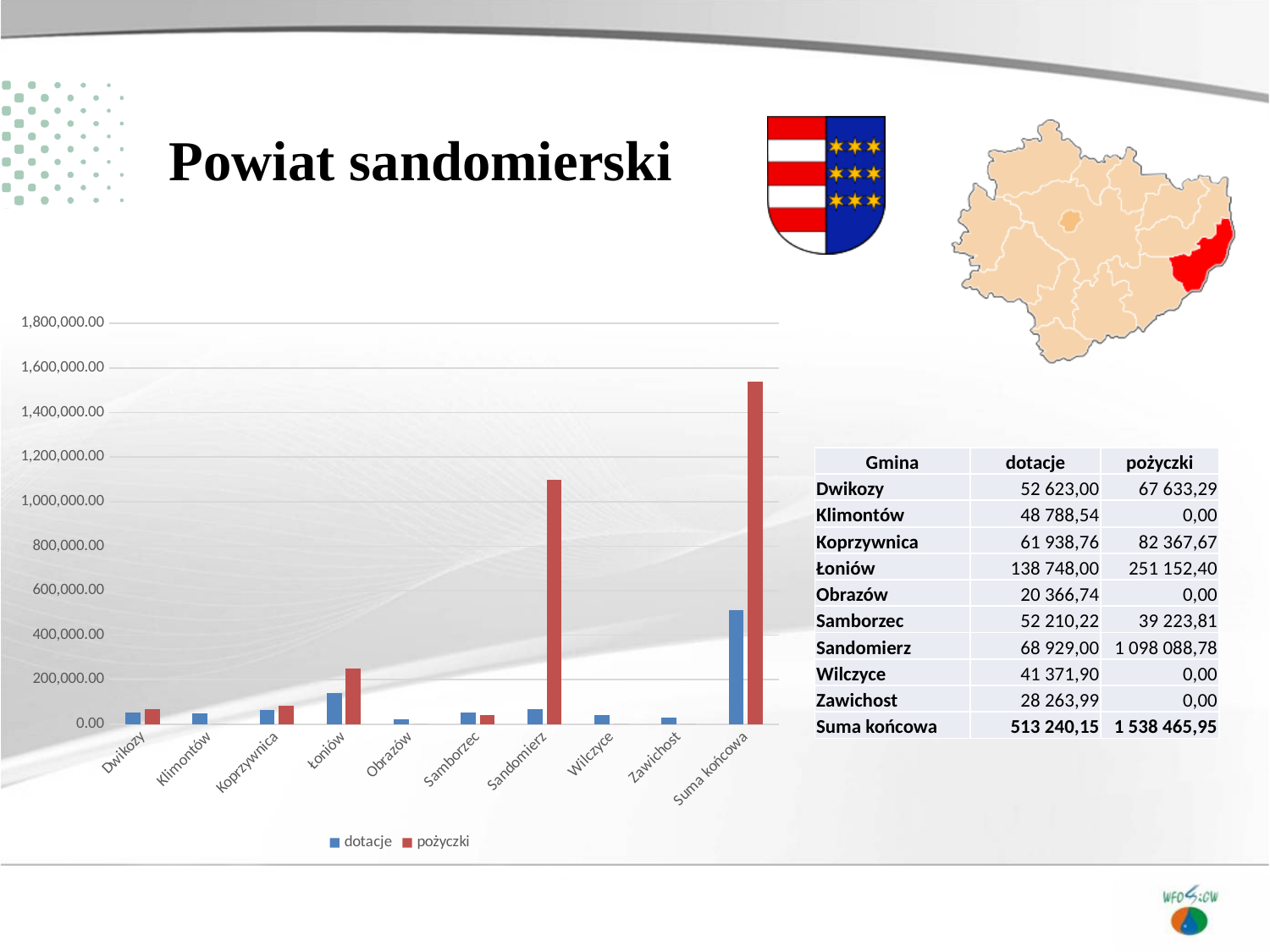
What is the difference between the pożyczki and dotacje values for Łoniów? 112 404,40 How many series does the chart legend list? 2 How many categories are shown along the x axis of the chart? 10 What are the two entries in the chart legend? dotacje, pożyczki Excluding Suma końcowa, which gmina has the lowest dotacje value? Obrazów What is the pożyczki value for Sandomierz? 1 098 088,78 Excluding Suma końcowa, which gmina has the highest pożyczki value? Sandomierz Is the pożyczki value for Sandomierz greater or less than 1,000,000.00? greater For Koprzywnica, which is larger: dotacje or pożyczki? pożyczki What is the dotacje value for Łoniów? 138 748,00 Is the dotacje value for Suma końcowa greater or less than 600,000.00? less What kind of chart is shown on the slide? bar chart